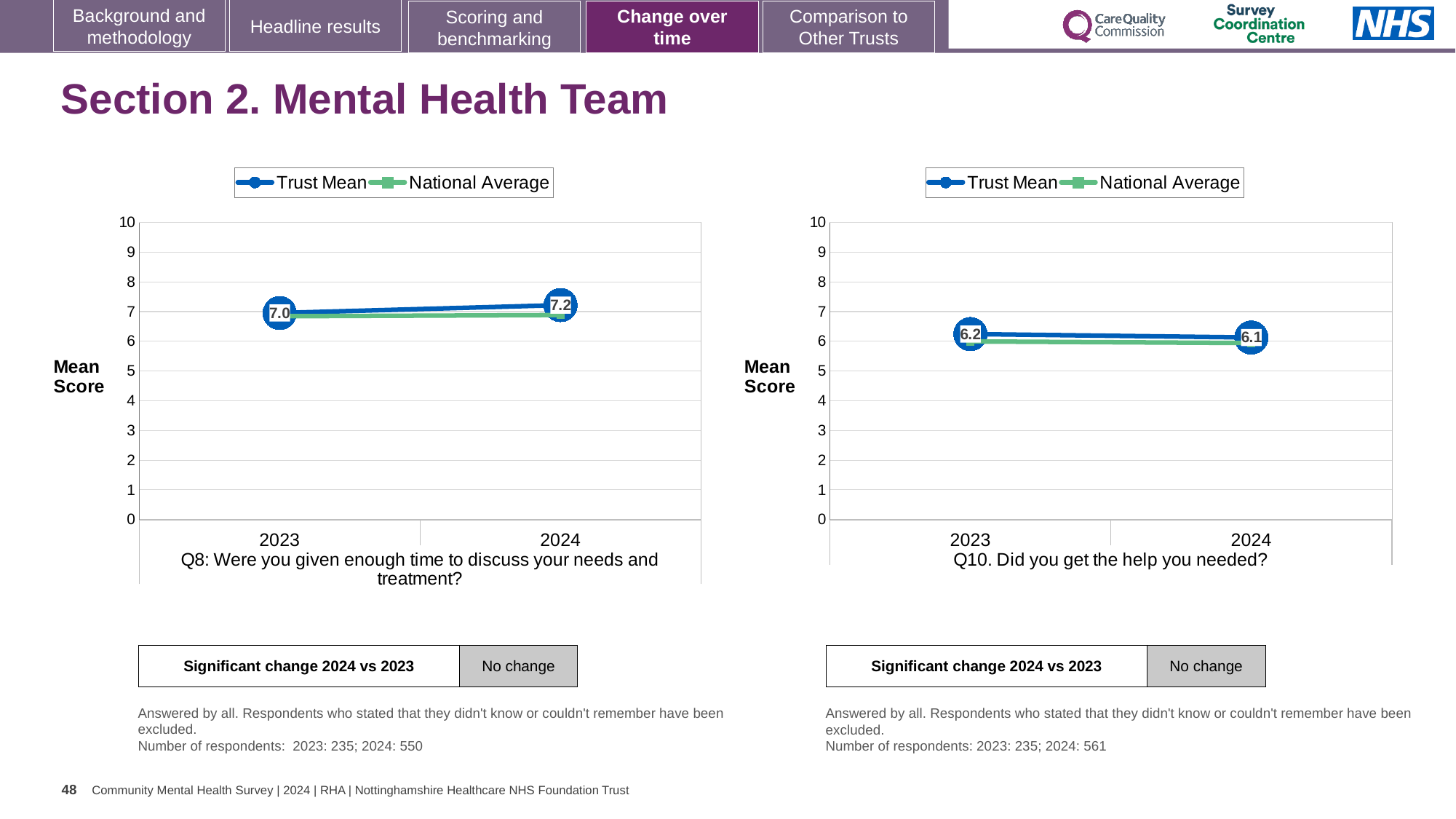
On the left chart (Q8), by how much did the Trust Mean change from 2023 to 2024? 0.2 How many years are plotted on the x axis of the left chart (Q8)? 2 On the left chart (Q8), what is the Trust Mean for 2024? 7.2 What kind of chart is the left chart (Q8)? line chart On the right chart (Q10), is the National Average for 2024 greater or less than 7? less On the right chart (Q10), what is the Trust Mean for 2023? 6.2 What is the label of the y axis on the left chart (Q8)? Mean Score How many series does the legend of the right chart (Q10) list? 2 On the right chart (Q10), what is the Trust Mean for 2024? 6.1 On the left chart (Q8), what is the Trust Mean for 2023? 7.0 On the left chart (Q8), does the Trust Mean rise or fall from 2023 to 2024? rise On the right chart (Q10), does the Trust Mean rise or fall from 2023 to 2024? fall